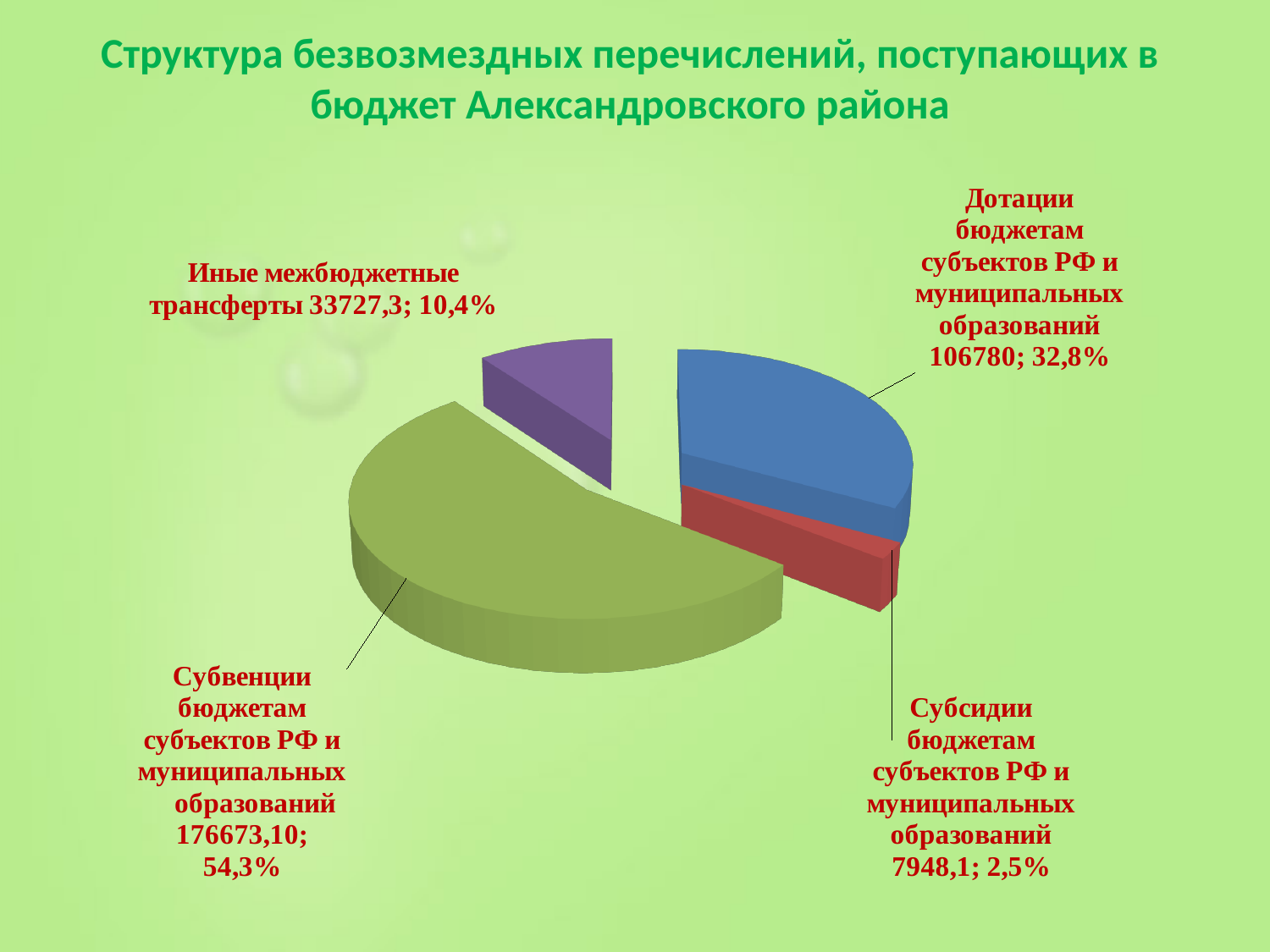
Which category has the largest share of the pie? Субвенции бюджетам субъектов РФ и муниципальных образований What share of the pie is Дотации бюджетам субъектов РФ и муниципальных образований? 32,8% What is the value shown for Субсидии бюджетам субъектов РФ и муниципальных образований? 7948,1 What kind of chart is shown on the slide? Pie chart Which is larger: the share for Дотации or the share for Иные межбюджетные трансферты? Дотации What is the difference in percentage share between Субвенции and Дотации? 21,5% What is the difference in value between Иные межбюджетные трансферты and Субсидии? 25779,2 Which category has the smallest share of the pie? Субсидии бюджетам субъектов РФ и муниципальных образований What is the value shown for Субвенции бюджетам субъектов РФ и муниципальных образований? 176673,10 What colour is the slice for Субвенции бюджетам субъектов РФ и муниципальных образований? Green How many slices does the pie chart have? 4 What share of the pie is Иные межбюджетные трансферты? 10,4%